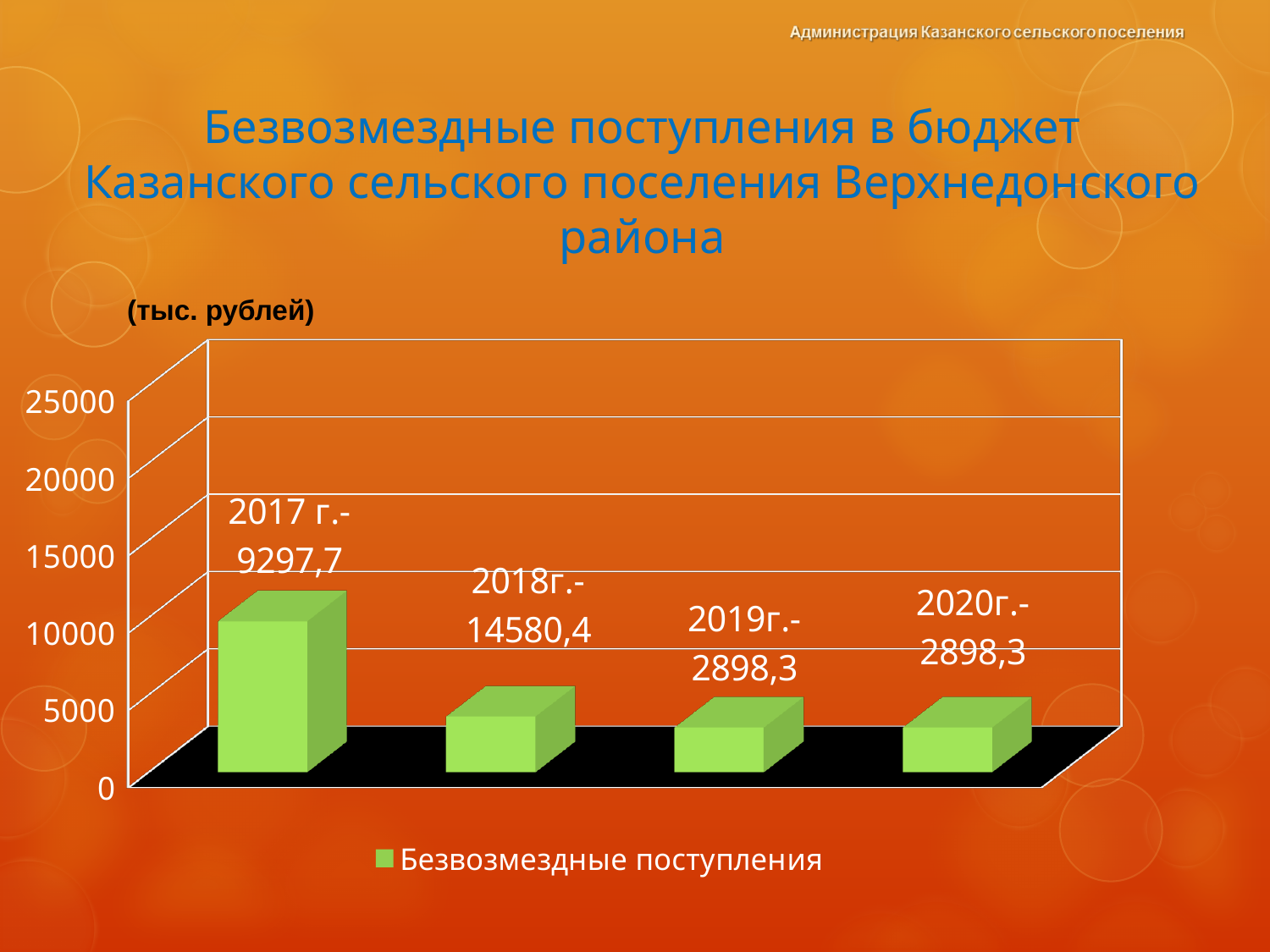
What value is shown in the label for 2020г.? 2898,3 Is the bar for 2017 г. greater or less than 15000? less How many years (categories) are shown on the chart? 4 What is the name of the series listed in the legend? Безвозмездные поступления How many series does the legend list? 1 What kind of chart is shown on the slide? bar chart What value is shown in the label for 2019г.? 2898,3 What value is shown in the label for 2017 г.? 9297,7 What value is shown in the label for 2018г.? 14580,4 What unit is indicated above the chart? (тыс. рублей) What is the difference between the labelled values for 2017 г. and 2019г.? 6399,4 Is the bar for 2017 г. greater or less than 5000? greater